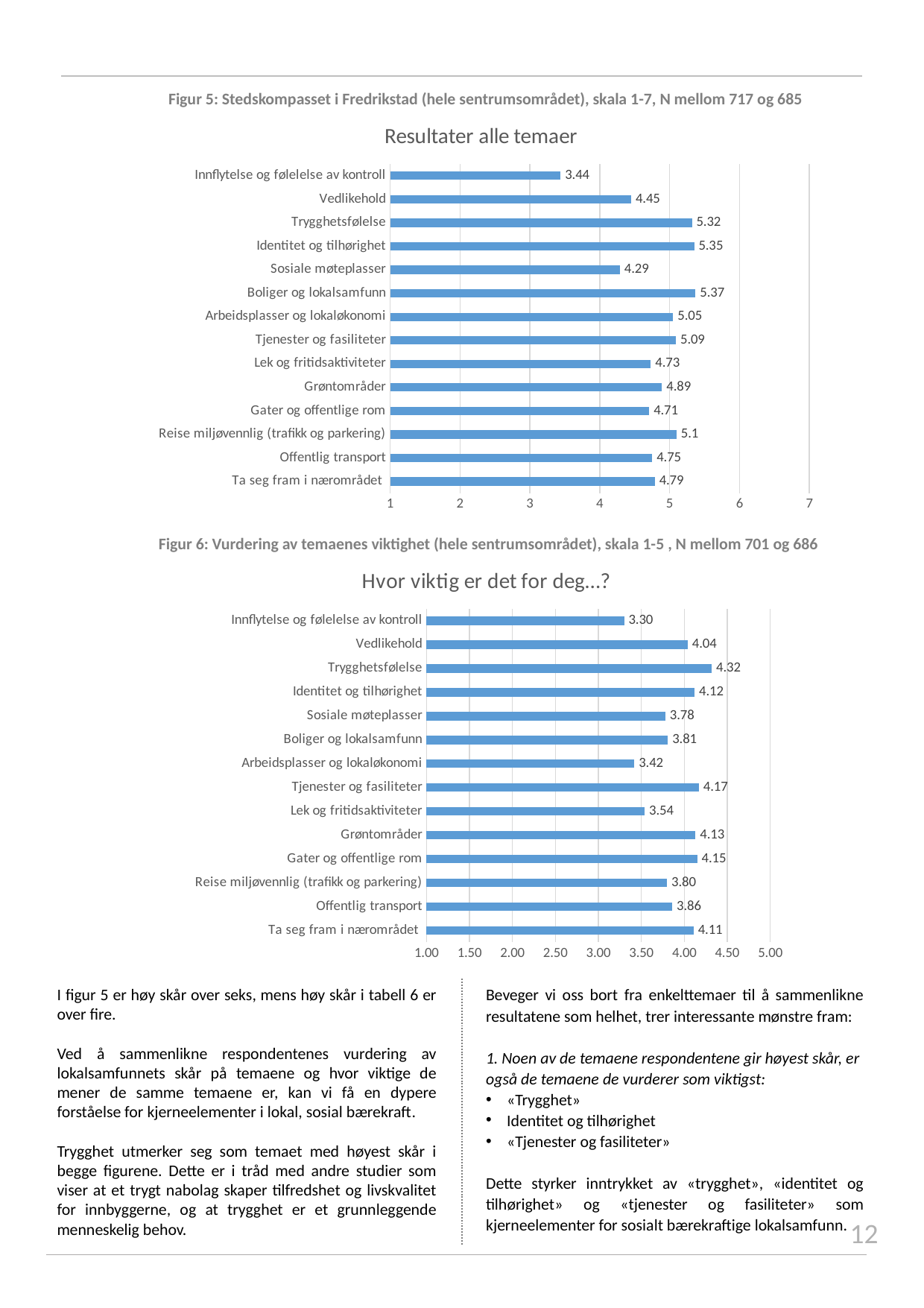
In the 'Resultater alle temaer' chart, how many categories are shown? 14 In the 'Resultater alle temaer' chart, what is the value for Reise miljøvennlig (trafikk og parkering)? 5.1 In the 'Hvor viktig er det for deg…?' chart, which is larger: Grøntområder or Lek og fritidsaktiviteter? Grøntområder In the 'Hvor viktig er det for deg…?' chart, what is the difference between Trygghetsfølelse and Arbeidsplasser og lokaløkonomi? 0.90 In the 'Hvor viktig er det for deg…?' chart, which category has the highest value? Trygghetsfølelse In the 'Resultater alle temaer' chart, which category has the lowest value? Innflytelse og følelelse av kontroll In the 'Resultater alle temaer' chart, what is the difference between Vedlikehold and Sosiale møteplasser? 0.16 In the 'Resultater alle temaer' chart, what is the value for Trygghetsfølelse? 5.32 In the 'Resultater alle temaer' chart, which category has the highest value? Boliger og lokalsamfunn In the 'Hvor viktig er det for deg…?' chart, what is the value for Tjenester og fasiliteter? 4.17 What kind of chart is 'Hvor viktig er det for deg…?'? Bar chart In the 'Hvor viktig er det for deg…?' chart, which category has the lowest value? Innflytelse og følelelse av kontroll